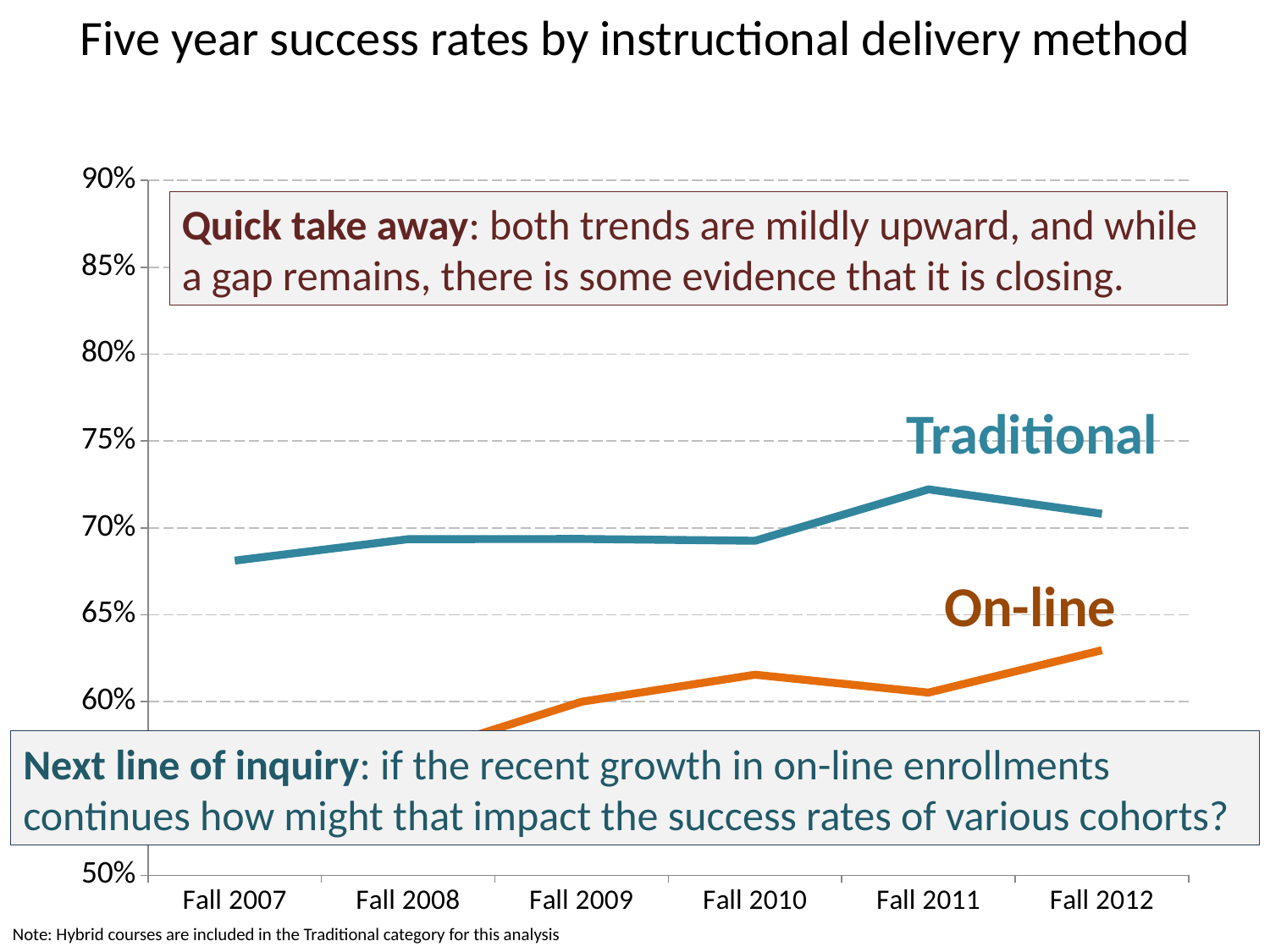
Does the On-line success rate rise or fall from Fall 2011 to Fall 2012? rise In which term does the Traditional series have its lowest value? Fall 2007 Is the Traditional success rate in Fall 2011 greater or less than 70%? greater Is the On-line success rate in Fall 2011 greater or less than 65%? less Which series has the higher success rate in Fall 2012, Traditional or On-line? Traditional What kind of chart is shown on the slide? line chart How many series are plotted on the chart? 2 Is the On-line success rate in Fall 2012 greater or less than 60%? greater How many time points are shown on the x axis? 6 In which term does the Traditional series reach its highest value? Fall 2011 What is the title of the chart? Five year success rates by instructional delivery method